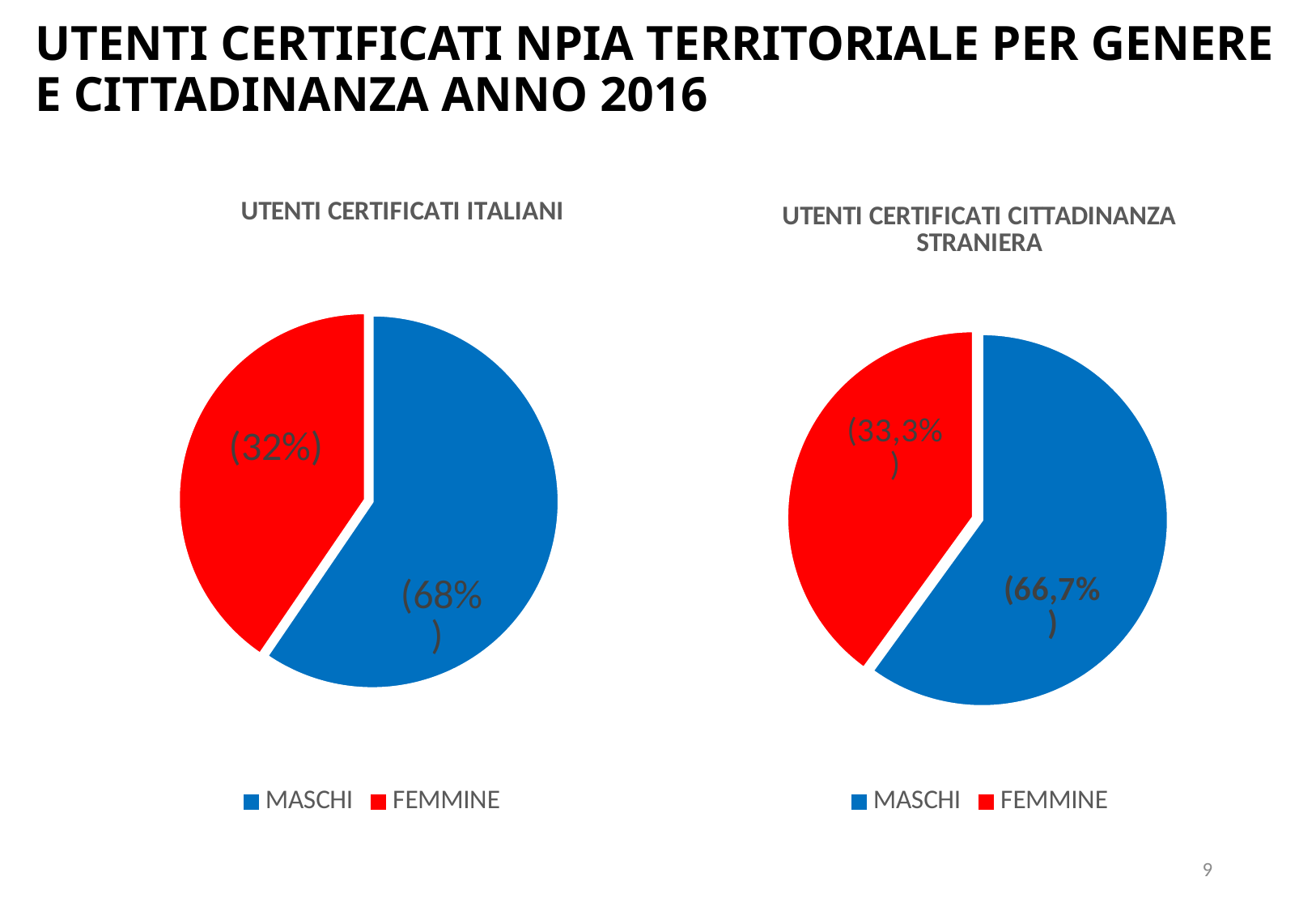
In the 'UTENTI CERTIFICATI ITALIANI' chart, what colour is the FEMMINE slice? Red What is the title of the chart on the right side of the slide? UTENTI CERTIFICATI CITTADINANZA STRANIERA In the 'UTENTI CERTIFICATI CITTADINANZA STRANIERA' chart, which is larger, MASCHI or FEMMINE? MASCHI What kind of chart is the 'UTENTI CERTIFICATI ITALIANI' chart? Pie chart In the 'UTENTI CERTIFICATI ITALIANI' chart, what is the difference in percentage points between MASCHI and FEMMINE? 36 How many slices does the 'UTENTI CERTIFICATI CITTADINANZA STRANIERA' chart have? 2 In the 'UTENTI CERTIFICATI ITALIANI' chart, what share of the pie is FEMMINE? 32% In the 'UTENTI CERTIFICATI ITALIANI' chart, what share of the pie is MASCHI? 68% In the 'UTENTI CERTIFICATI CITTADINANZA STRANIERA' chart, which category has the smallest slice? FEMMINE In the 'UTENTI CERTIFICATI ITALIANI' chart, which category has the largest slice? MASCHI In the 'UTENTI CERTIFICATI CITTADINANZA STRANIERA' chart, what share of the pie is FEMMINE? 33,3%